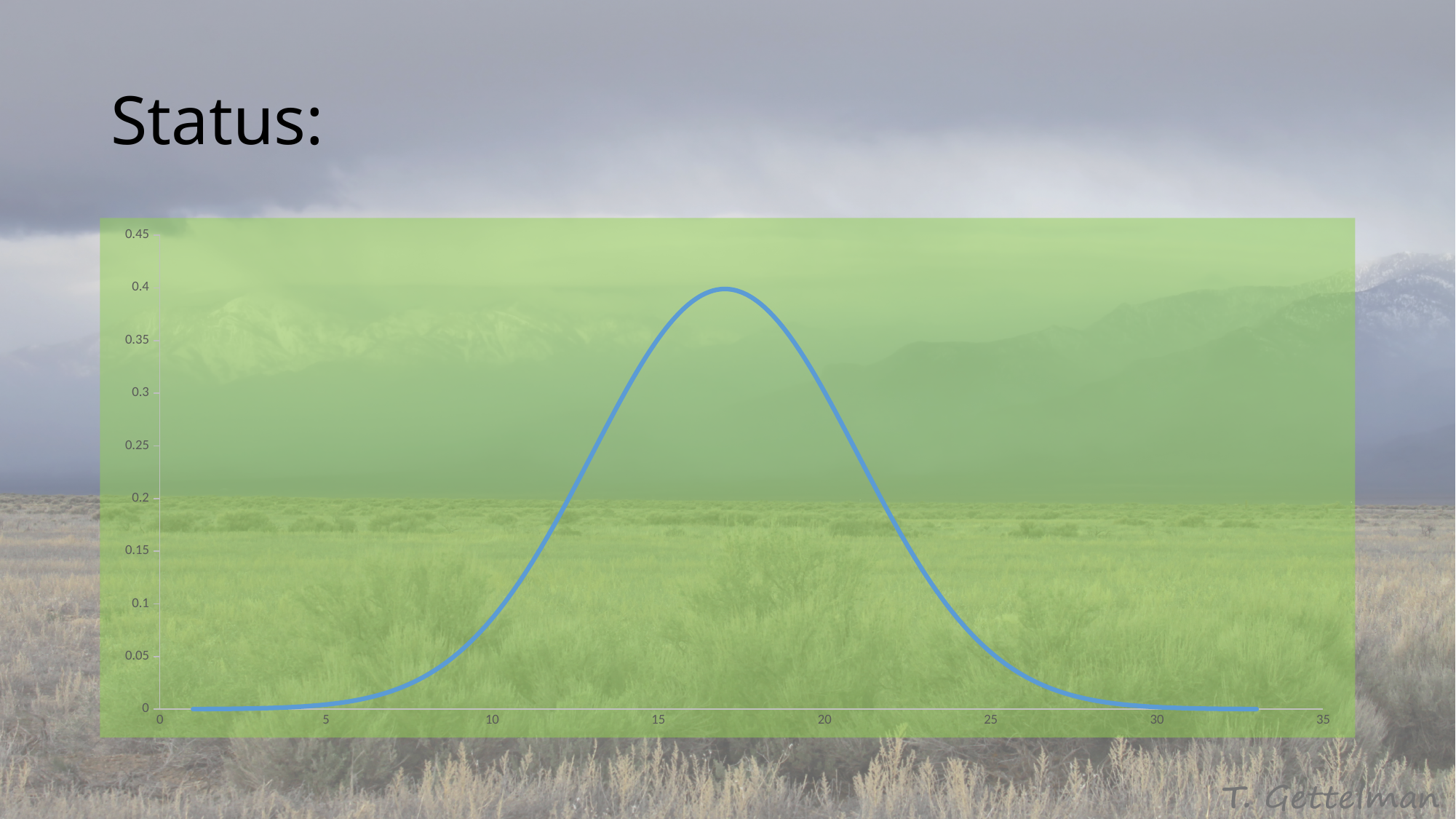
What is the title of the slide containing the chart? Status: Is the peak value of the curve greater or less than 0.45? less Is the value of the curve at x = 15 greater or less than 0.25? greater Is the value of the curve at x = 5 greater or less than 0.05? less What is the highest tick label shown on the y axis of the chart? 0.45 What kind of chart is shown on the slide? line chart Which is larger, the value of the curve at x = 15 or at x = 25? x = 15 Between x = 5 and x = 15, does the curve rise or fall? rise Between x = 20 and x = 30, does the curve rise or fall? fall